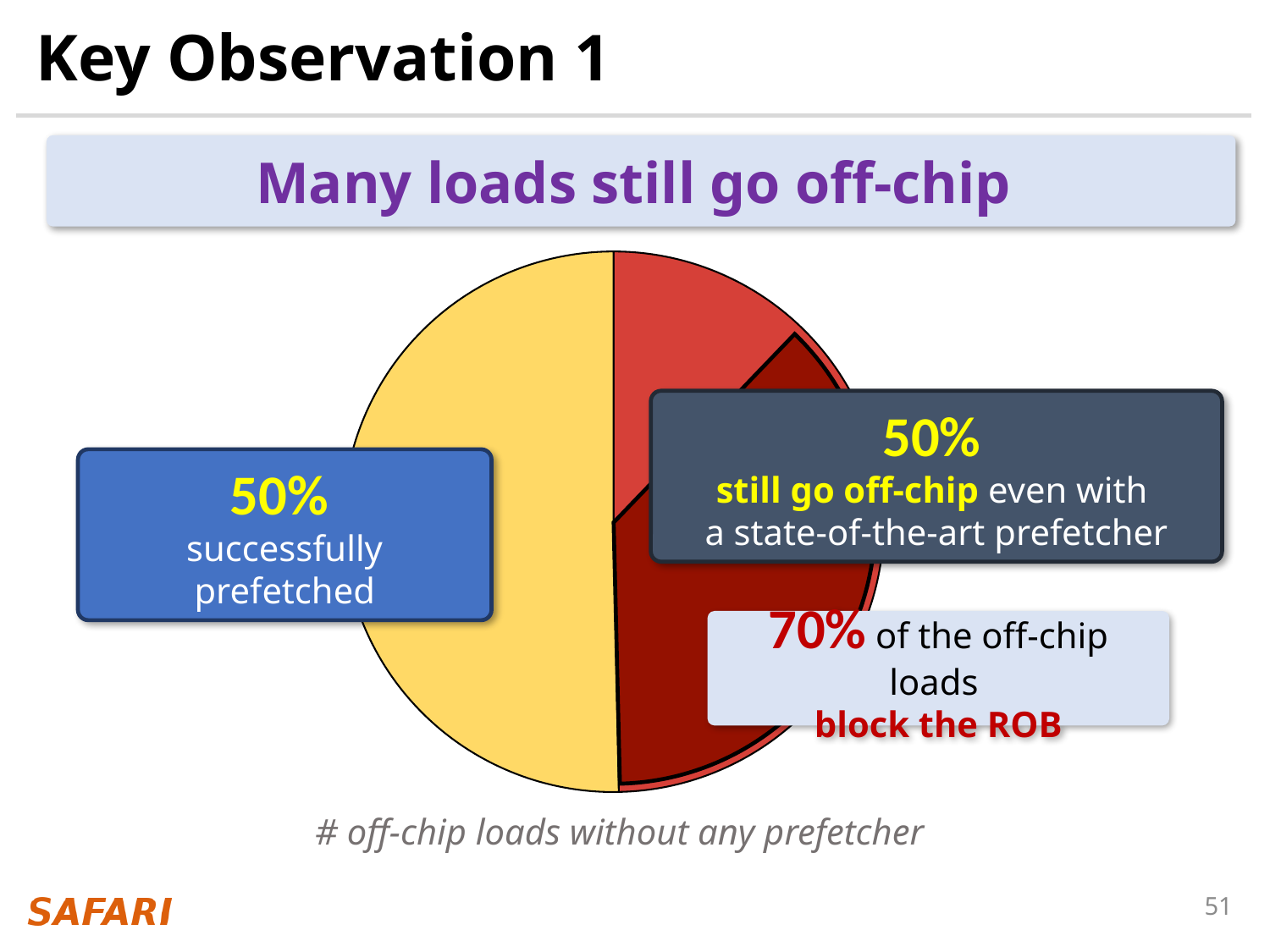
What share of the pie is labelled as successfully prefetched? 50% What colour is the slice representing loads that were successfully prefetched? yellow What kind of chart is shown on the slide? pie chart What does the caption below the pie chart say the chart represents? # off-chip loads without any prefetcher What share of loads still go off-chip even with a state-of-the-art prefetcher? 50% How many distinct coloured regions does the pie chart show? 3 Is the percentage of off-chip loads that block the ROB greater or less than 50%? greater What percentage of the off-chip loads block the ROB? 70% Is the share of loads successfully prefetched equal to the share that still go off-chip? Yes